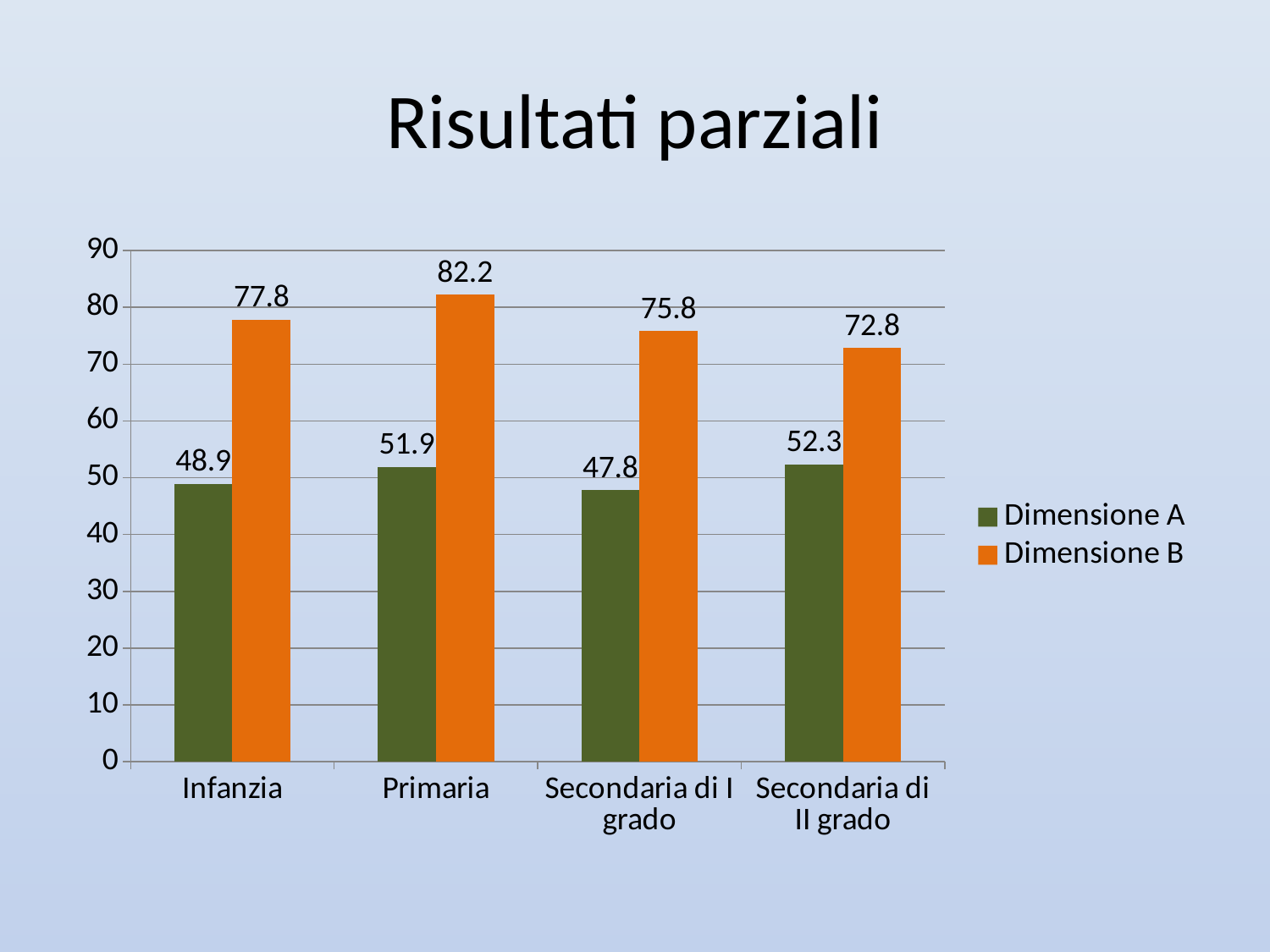
How many series does the legend list? 2 What is the value of Dimensione B for Secondaria di II grado? 72.8 What is the value of Dimensione A for Secondaria di I grado? 47.8 What kind of chart is shown on the slide? bar chart What is the title of the slide? Risultati parziali What is the difference between Dimensione B and Dimensione A for Infanzia? 28.9 What is the value of Dimensione B for Primaria? 82.2 Which category has the highest value for Dimensione B? Primaria Which category has the lowest value for Dimensione A? Secondaria di I grado How many categories are shown on the x axis? 4 Which is larger for Primaria: Dimensione A or Dimensione B? Dimensione B Is the value of Dimensione A for Secondaria di II grado greater or less than 50? greater